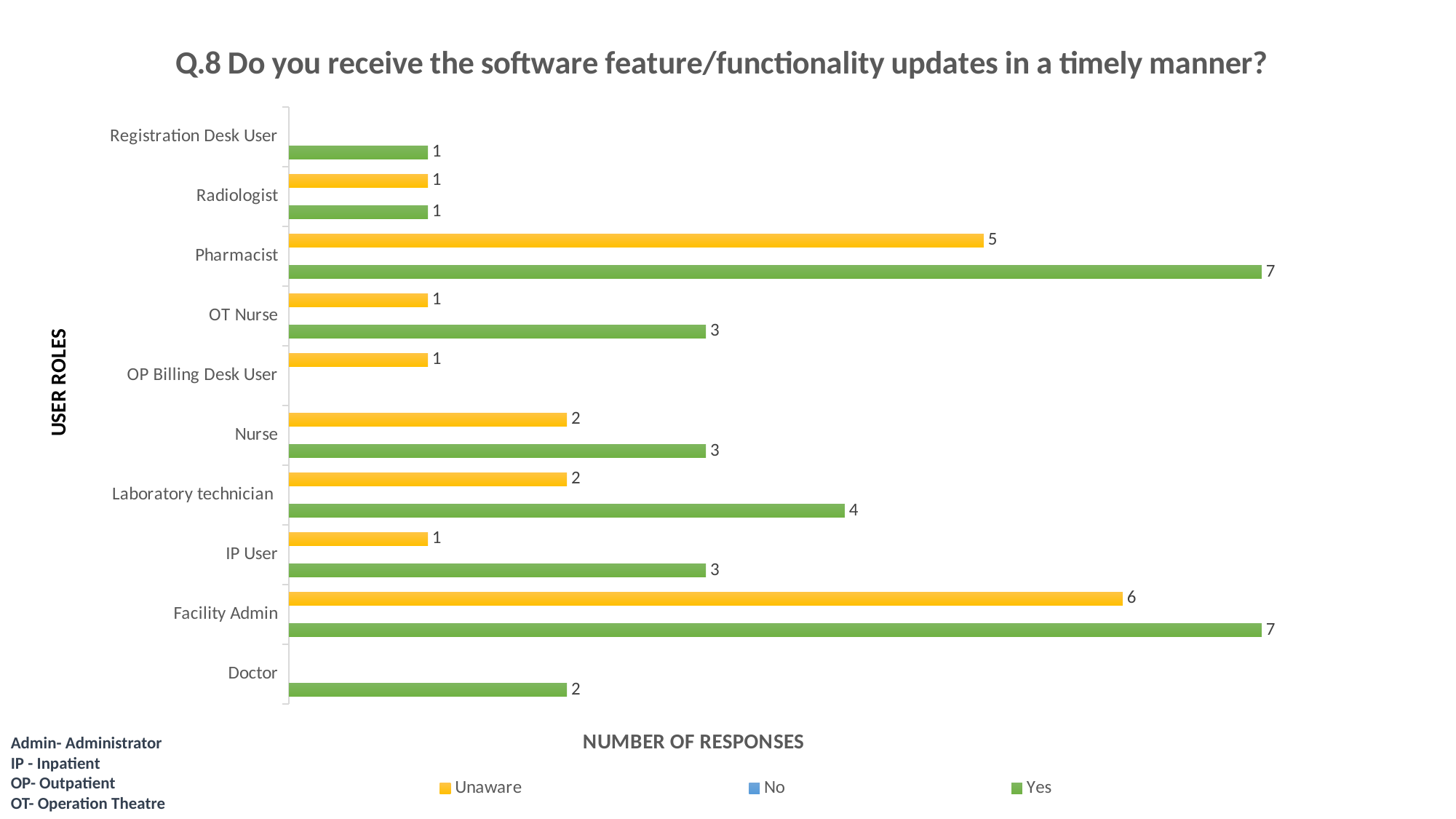
What kind of chart is shown? Bar chart Which user role has the highest 'Unaware' value? Facility Admin How many user roles are listed on the vertical axis? 10 What is the title of the chart? Q.8 Do you receive the software feature/functionality updates in a timely manner? What is the label of the horizontal axis? NUMBER OF RESPONSES What is the 'Yes' value for Pharmacist? 7 What is the 'Unaware' value for Facility Admin? 6 Which is larger, the 'Yes' value for OT Nurse or the 'Yes' value for Laboratory technician? Laboratory technician What is the 'Yes' value for Laboratory technician? 4 What is the 'Unaware' value for Nurse? 2 How many series does the legend list? 3 What is the difference between the 'Yes' and 'Unaware' values for Pharmacist? 2